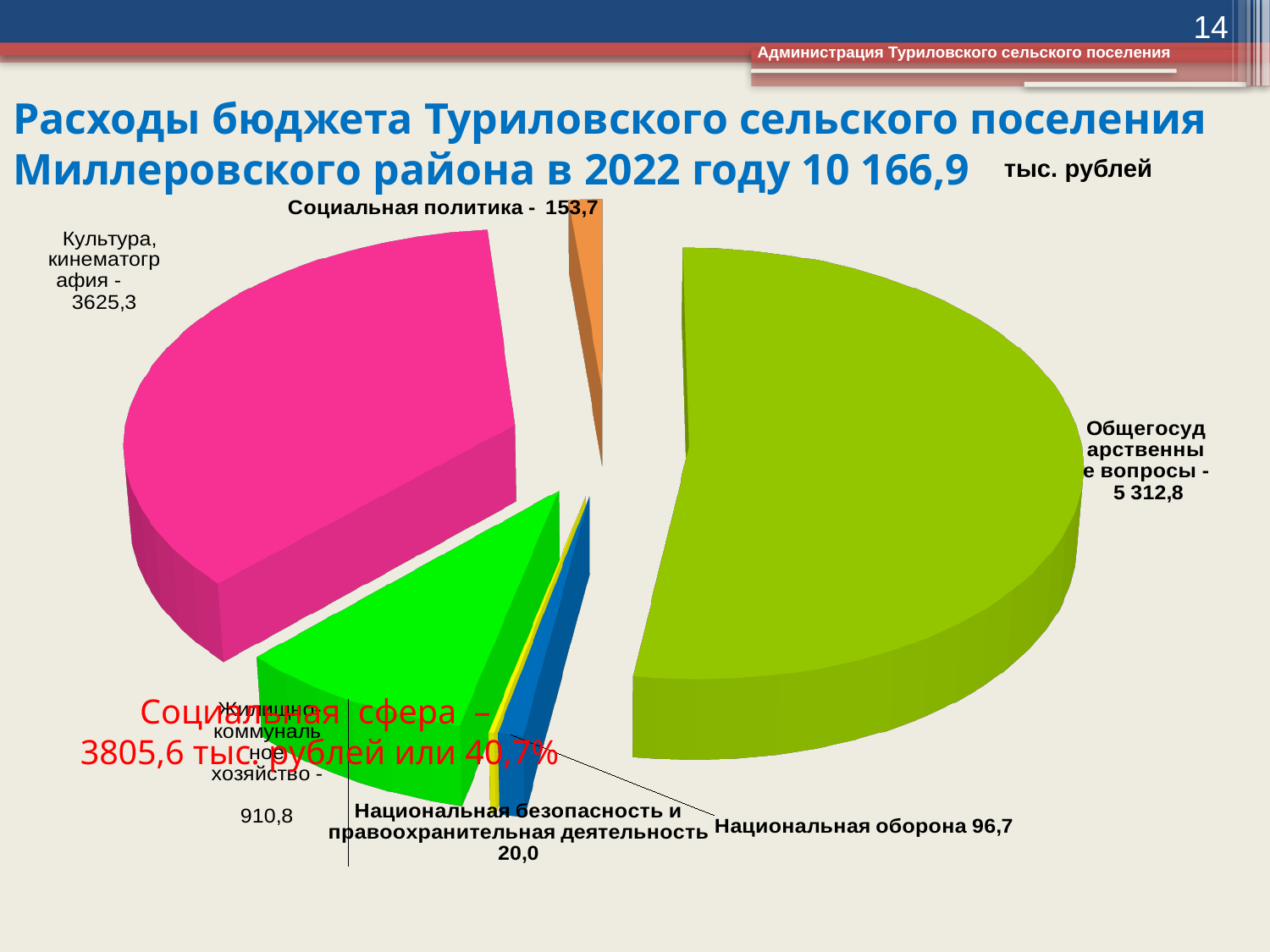
What is the value for Жилищно-коммунальное хозяйство? 910,8 According to the slide title, what is the total budget expenditure in 2022 (тыс. рублей)? 10 166,9 Which category has the smallest slice of the pie? Национальная безопасность и правоохранительная деятельность Which is larger: the value for Социальная политика or the value for Национальная оборона? Социальная политика How many slices does the pie chart have? 6 Which category has the largest slice of the pie? Общегосударственные вопросы What is the value for Культура, кинематография? 3625,3 What kind of chart is shown on the slide? Pie chart What is the difference between the values for Общегосударственные вопросы and Культура, кинематография? 1687,5 What is the value for Общегосударственные вопросы? 5 312,8 What is the value for Национальная оборона? 96,7 What is the value for Социальная политика? 153,7